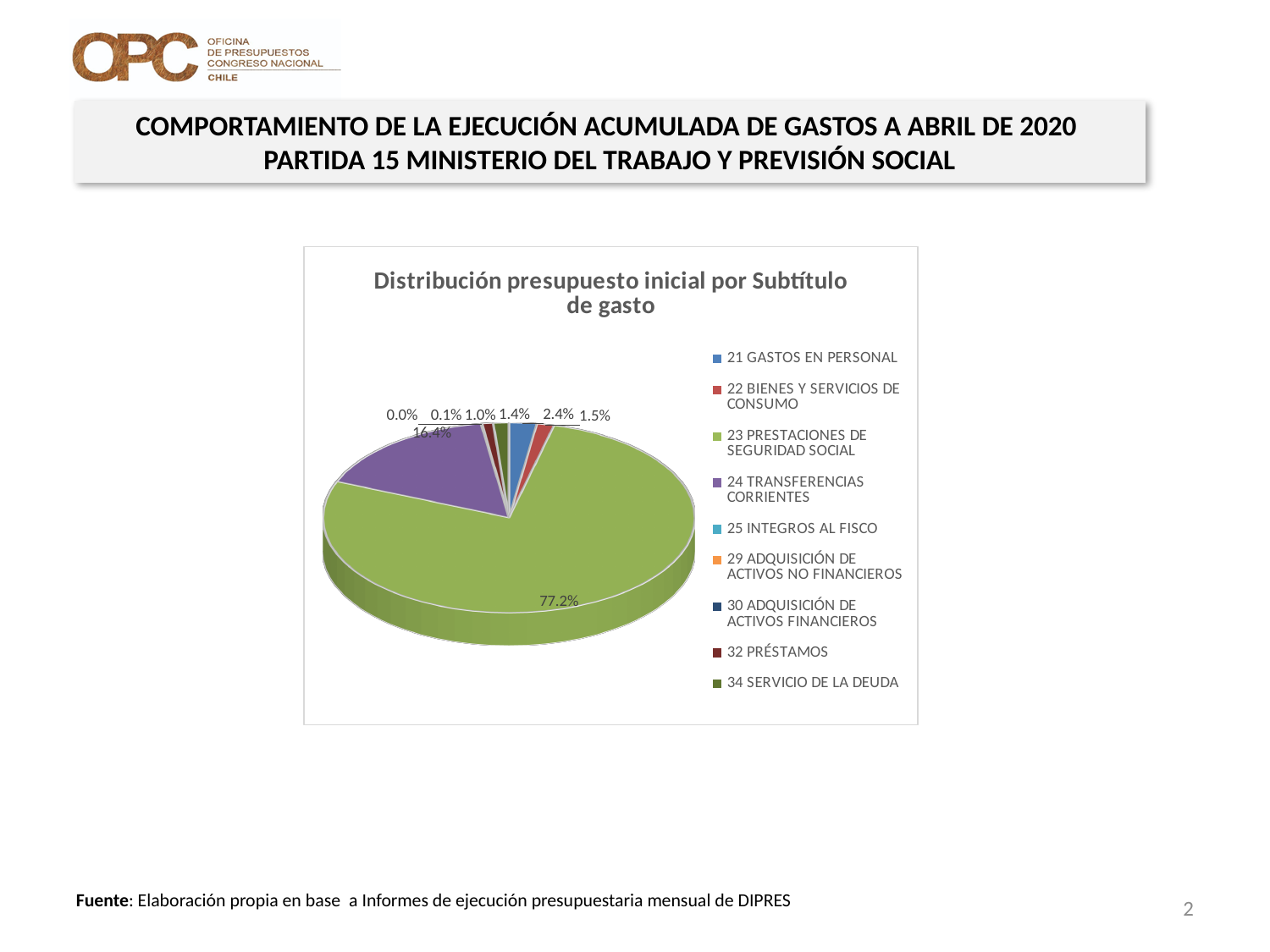
What is the difference in percentage points between the shares of 23 PRESTACIONES DE SEGURIDAD SOCIAL and 24 TRANSFERENCIAS CORRIENTES? 60.8 percentage points Which is larger, the share for 21 GASTOS EN PERSONAL or for 22 BIENES Y SERVICIOS DE CONSUMO? 21 GASTOS EN PERSONAL What is the value shown for 21 GASTOS EN PERSONAL? 2.4% Which category has the largest share of the pie? 23 PRESTACIONES DE SEGURIDAD SOCIAL What share of the pie does 23 PRESTACIONES DE SEGURIDAD SOCIAL represent? 77.2% What kind of chart is shown on the slide? Pie chart What is the smallest percentage label shown on the pie? 0.0% What is the title of the chart? Distribución presupuesto inicial por Subtítulo de gasto How many categories does the chart's legend list? 9 What share of the pie does 24 TRANSFERENCIAS CORRIENTES represent? 16.4% What is the combined share of 23 PRESTACIONES DE SEGURIDAD SOCIAL and 24 TRANSFERENCIAS CORRIENTES? 93.6% What is the value shown for 22 BIENES Y SERVICIOS DE CONSUMO? 1.5%